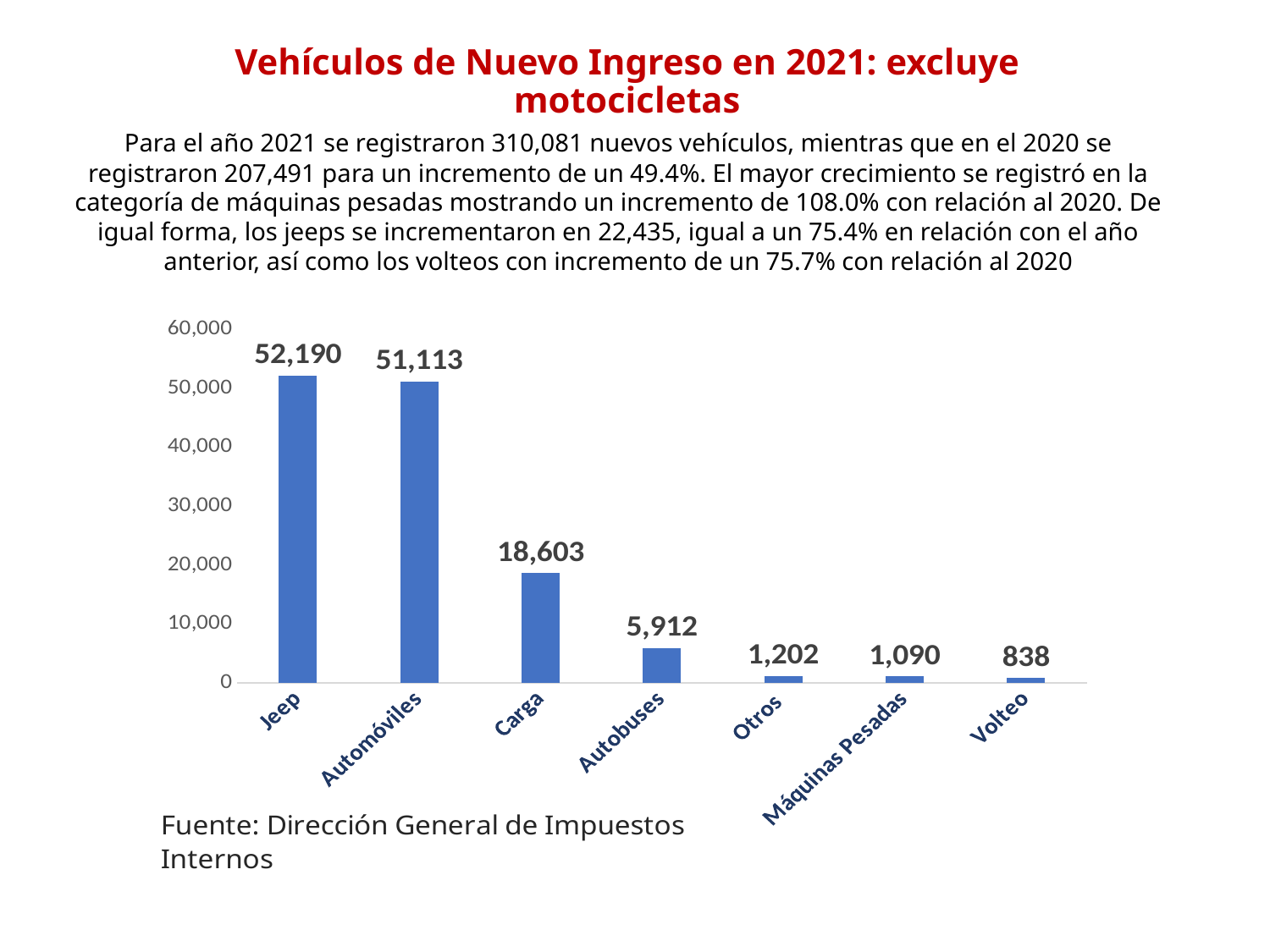
What kind of chart is shown on the slide? bar chart What is the difference between the values for Carga and Autobuses? 12,691 How many categories are shown on the x axis? 7 What is the value for Carga? 18,603 Which category has the lowest value? Volteo What is the value for Jeep? 52,190 What source is cited below the chart? Dirección General de Impuestos Internos Which category has the highest value? Jeep Which is larger, the value for Otros or the value for Volteo? Otros Is the value for Autobuses greater or less than 10,000? less What is the difference between the values for Jeep and Automóviles? 1,077 What is the value for Máquinas Pesadas? 1,090